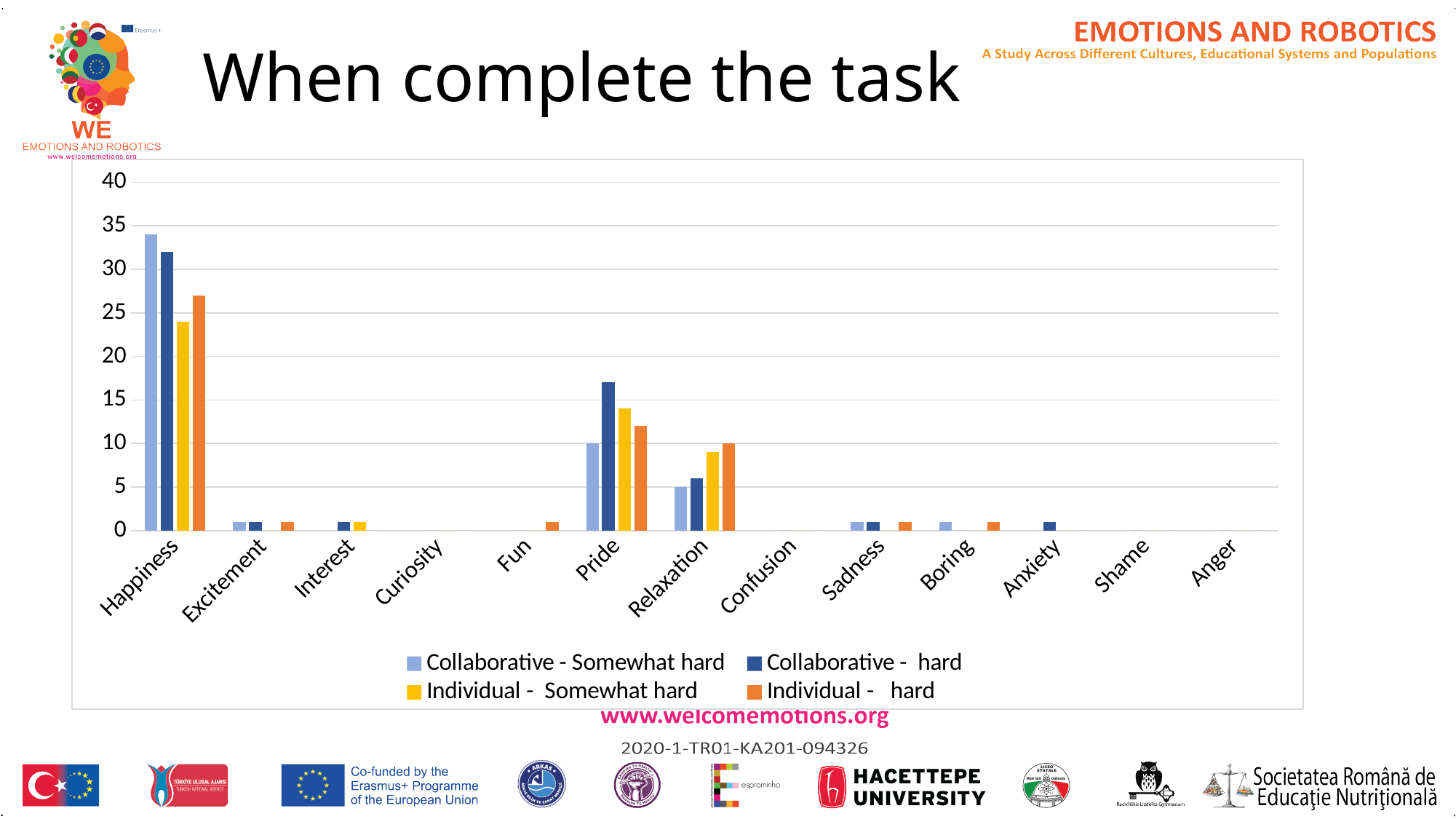
Is the value for Happiness in the Collaborative - Somewhat hard series greater or less than 30? greater How many emotion categories are shown on the x axis? 13 What is the value for Relaxation in the Individual - hard series? 10 What colour represents the Individual - hard series in the legend? orange What is the value for Pride in the Collaborative - Somewhat hard series? 10 What is the value for Relaxation in the Collaborative - Somewhat hard series? 5 Is the value for Happiness in the Individual - Somewhat hard series greater or less than 25? less How many series does the legend list? 4 What kind of chart is shown on the slide? bar chart For Pride, which series has the larger value: Collaborative - hard or Individual - hard? Collaborative - hard Which emotion has the highest value for the Collaborative - Somewhat hard series? Happiness Which emotion has the highest value for the Individual - hard series? Happiness